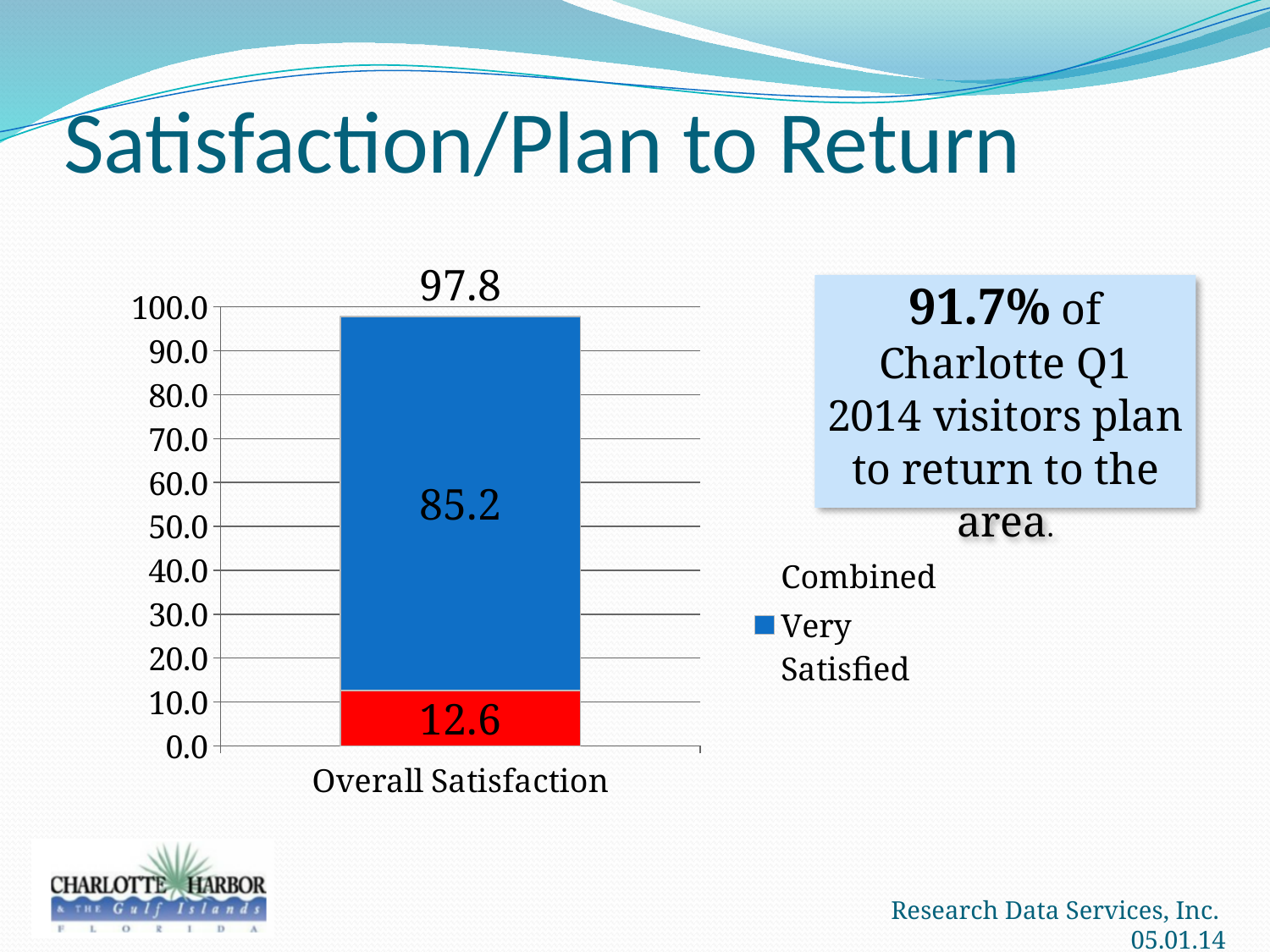
What kind of chart is shown on the slide? Stacked bar chart What is the difference between the Very Satisfied value (85.2) and the red segment value (12.6)? 72.6 Which segment of the Overall Satisfaction bar is larger, the blue Very Satisfied segment or the red segment? Very Satisfied What is the label of the category on the x axis? Overall Satisfaction Which segment of the stacked bar has the highest value? Very Satisfied Is the value of the red segment greater or less than 20.0? less What is the value of the Very Satisfied segment in the Overall Satisfaction bar? 85.2 Is the value of the Very Satisfied segment greater or less than 80.0? greater What colour is used for the Very Satisfied series in the chart? Blue What is the value of the red segment at the bottom of the Overall Satisfaction bar? 12.6 How many categories are plotted on the x axis of the chart? 1 What is the total value printed above the Overall Satisfaction stacked bar? 97.8